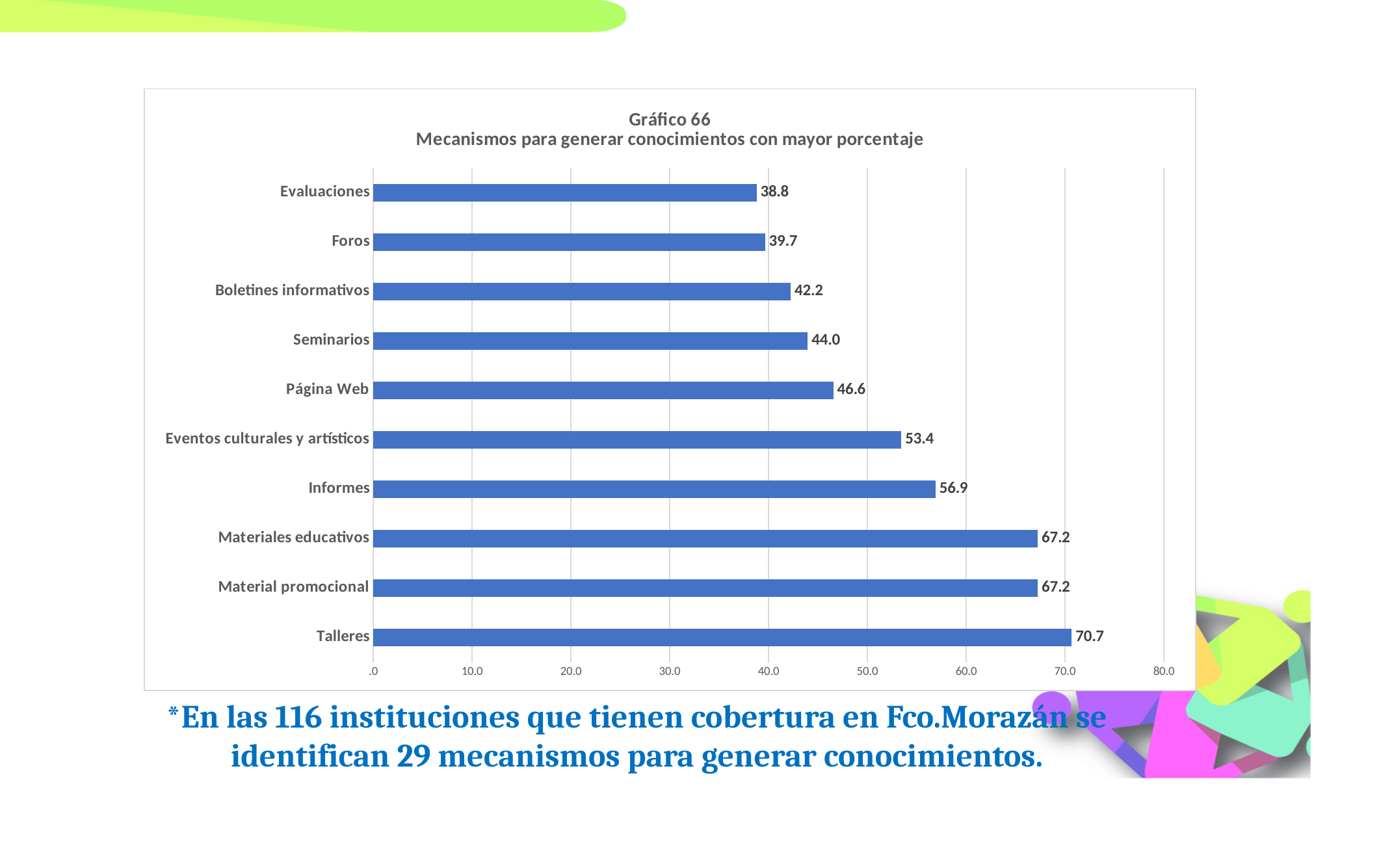
How many categories are shown in the chart? 10 What is the number of the chart given in its title? Gráfico 66 What is the difference between the values for Talleres and Informes? 13.8 What is the difference between the values for Seminarios and Foros? 4.3 What is the value for Página Web? 46.6 What is the value for Evaluaciones? 38.8 Which category has the highest value? Talleres What is the value for Talleres? 70.7 Which category has the lowest value? Evaluaciones Is the value for Materiales educativos greater or less than 60.0? greater Which is larger, the value for Eventos culturales y artísticos or the value for Boletines informativos? Eventos culturales y artísticos What kind of chart is shown on the slide? Bar chart